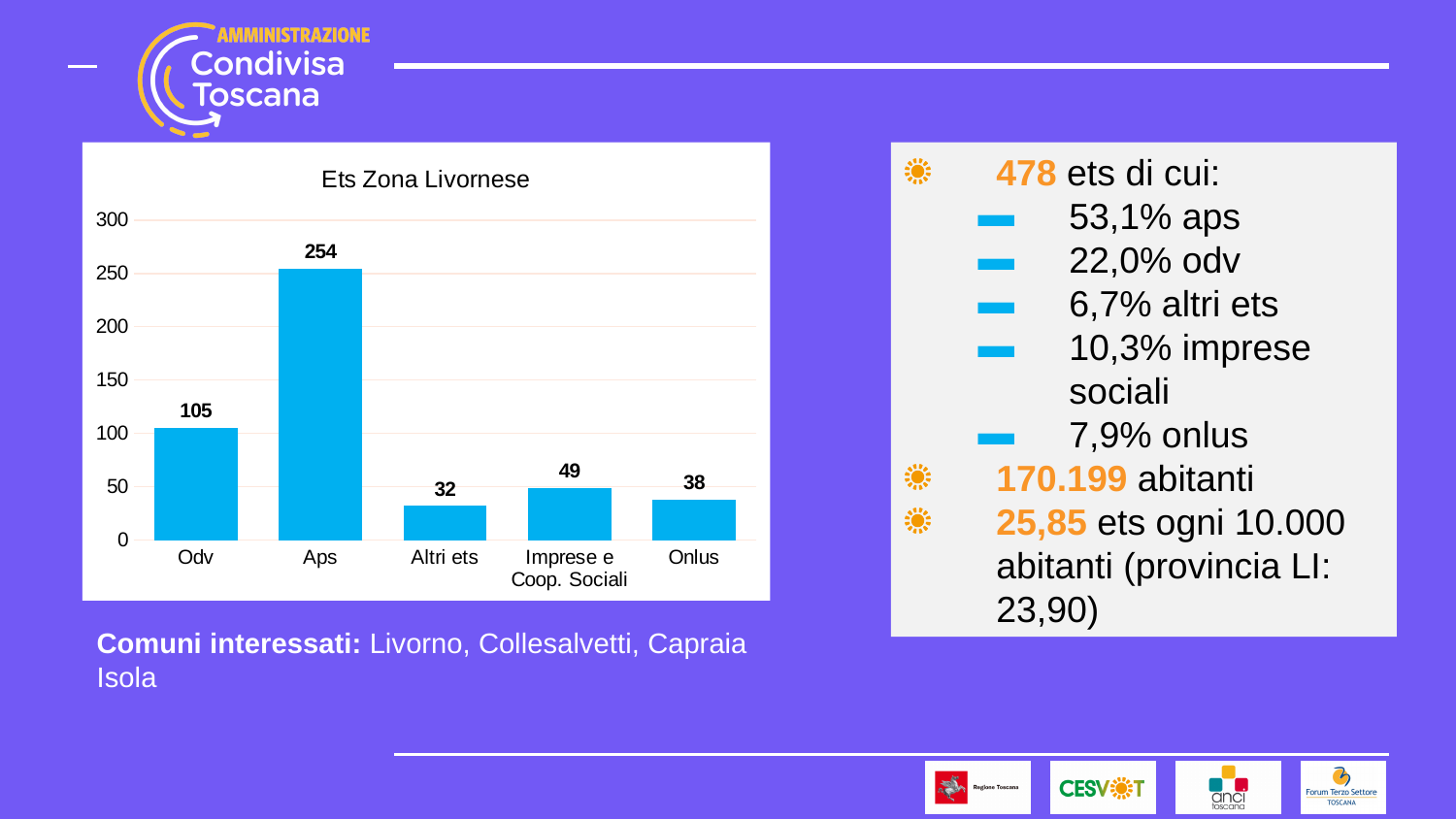
What is the value for Imprese e Coop. Sociali in the chart? 49 How many categories are shown in the chart? 5 What is the title of the chart? Ets Zona Livornese What is the total of the values for Altri ets and Onlus? 70 Is the value for Odv greater or less than 100? greater What is the difference between the values for Aps and Odv? 149 Which is larger, the value for Onlus or the value for Imprese e Coop. Sociali? Imprese e Coop. Sociali What is the value for Odv in the chart? 105 What kind of chart is shown on the slide? bar chart Which category has the lowest value in the chart? Altri ets What is the value for Aps in the chart? 254 Which category has the highest value in the chart? Aps